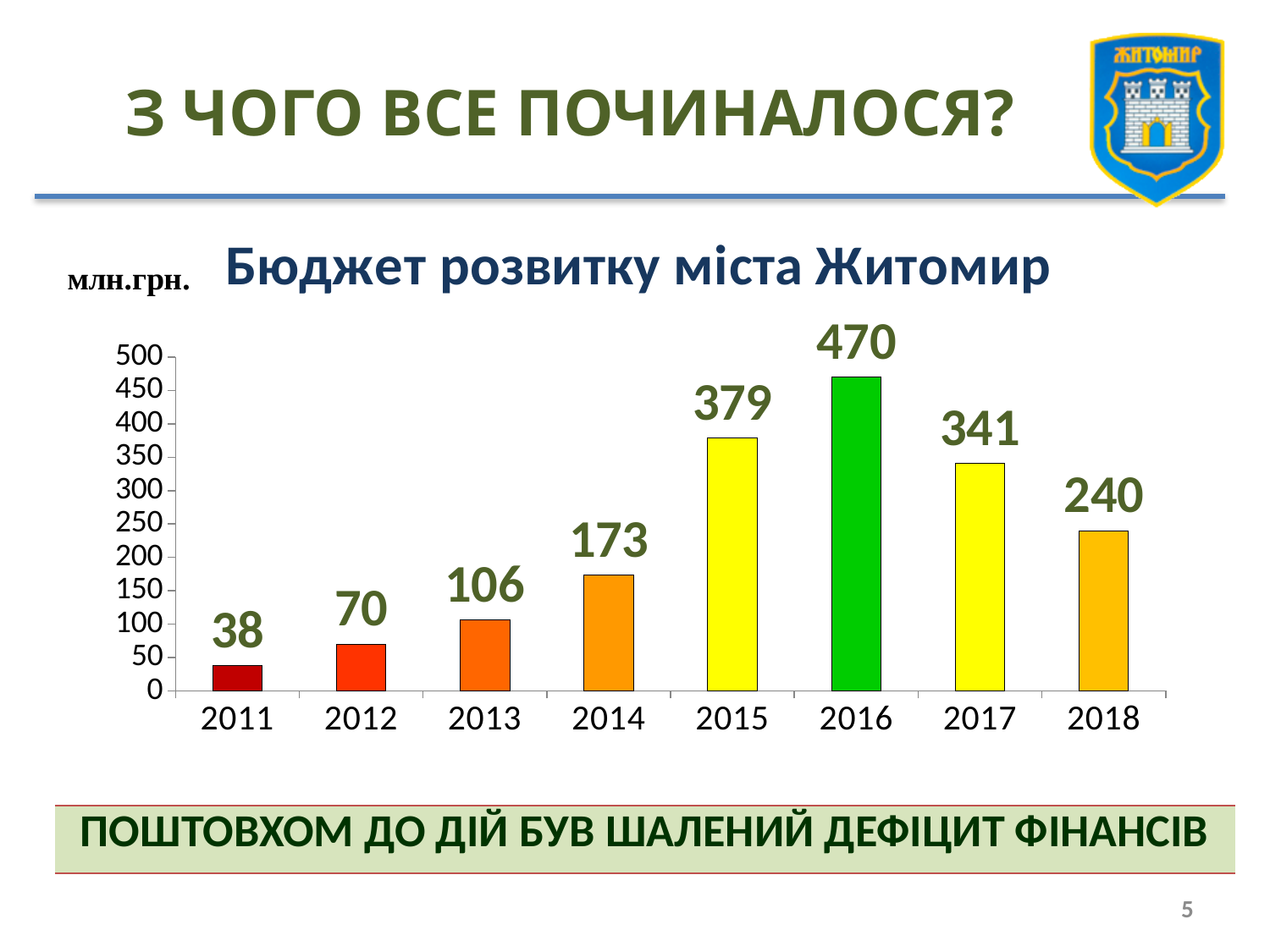
How many years are shown on the x axis? 8 Which year has the lowest value? 2011 Which is larger, the value for 2017 or the value for 2018? 2017 Which year has the highest value? 2016 What is the difference between the values for 2015 and 2014? 206 What is the value for 2016? 470 Is the value for 2015 greater or less than 350? greater What is the value for 2011? 38 What is the difference between the values for 2016 and 2017? 129 What is the title of the chart? Бюджет розвитку міста Житомир What kind of chart is shown? bar chart What is the value for 2014? 173